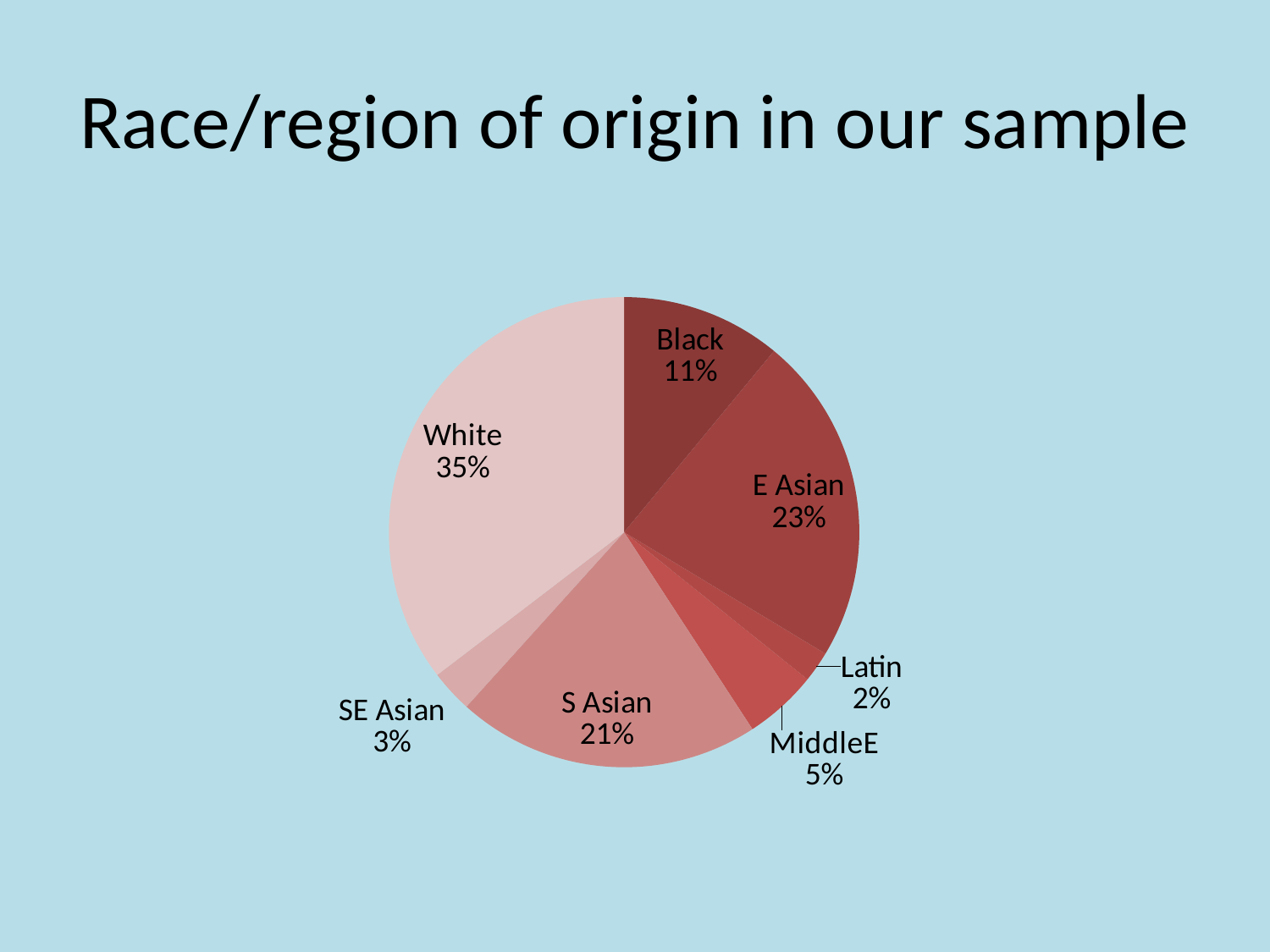
What share of the sample is S Asian? 21% What is the difference in percentage points between the White and Black shares? 24 What share of the sample is MiddleE? 5% How many race/region categories are shown in the pie chart? 7 Which has a larger share of the sample, E Asian or S Asian? E Asian Which race/region has the smallest share of the sample? Latin What share of the sample is White? 35% Which race/region has the largest share of the sample? White What share of the sample is E Asian? 23% What kind of chart is shown on the slide? Pie chart What is the title of the chart on the slide? Race/region of origin in our sample What share of the sample is Black? 11%